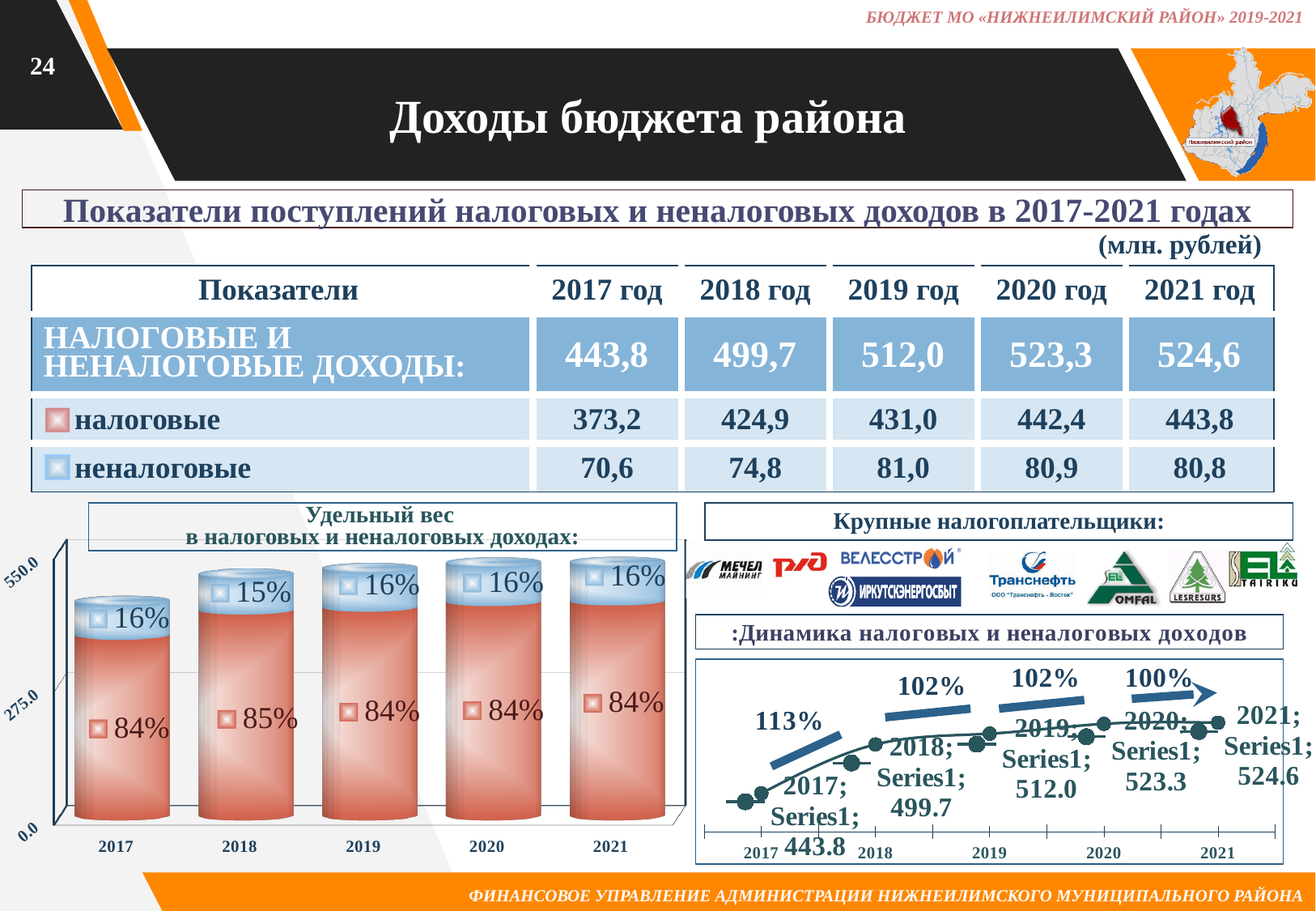
In the chart 'Динамика налоговых и неналоговых доходов', do the values rise or fall from 2017 to 2021? Rise In the chart 'Динамика налоговых и неналоговых доходов', what is the difference between the 2018 and 2017 values? 55.9 In the chart 'Удельный вес в налоговых и неналоговых доходах', what is the share of неналоговые in 2017? 16% In the chart 'Динамика налоговых и неналоговых доходов', which year has the highest value? 2021 In the chart 'Удельный вес в налоговых и неналоговых доходах', how many years are shown on the x axis? 5 In the chart 'Удельный вес в налоговых и неналоговых доходах', in which year is the share of неналоговые lowest? 2018 In the chart 'Динамика налоговых и неналоговых доходов', what growth percentage is shown between 2017 and 2018? 113% In the chart 'Динамика налоговых и неналоговых доходов', what is the value for 2019? 512.0 What kind of chart is 'Удельный вес в налоговых и неналоговых доходах'? Stacked bar chart In the chart 'Удельный вес в налоговых и неналоговых доходах', what is the share of налоговые in 2018? 85% In the chart 'Динамика налоговых и неналоговых доходов', what is the value for 2017? 443.8 In the chart 'Удельный вес в налоговых и неналоговых доходах', what is the difference between the налоговые and неналоговые shares in 2021? 68%